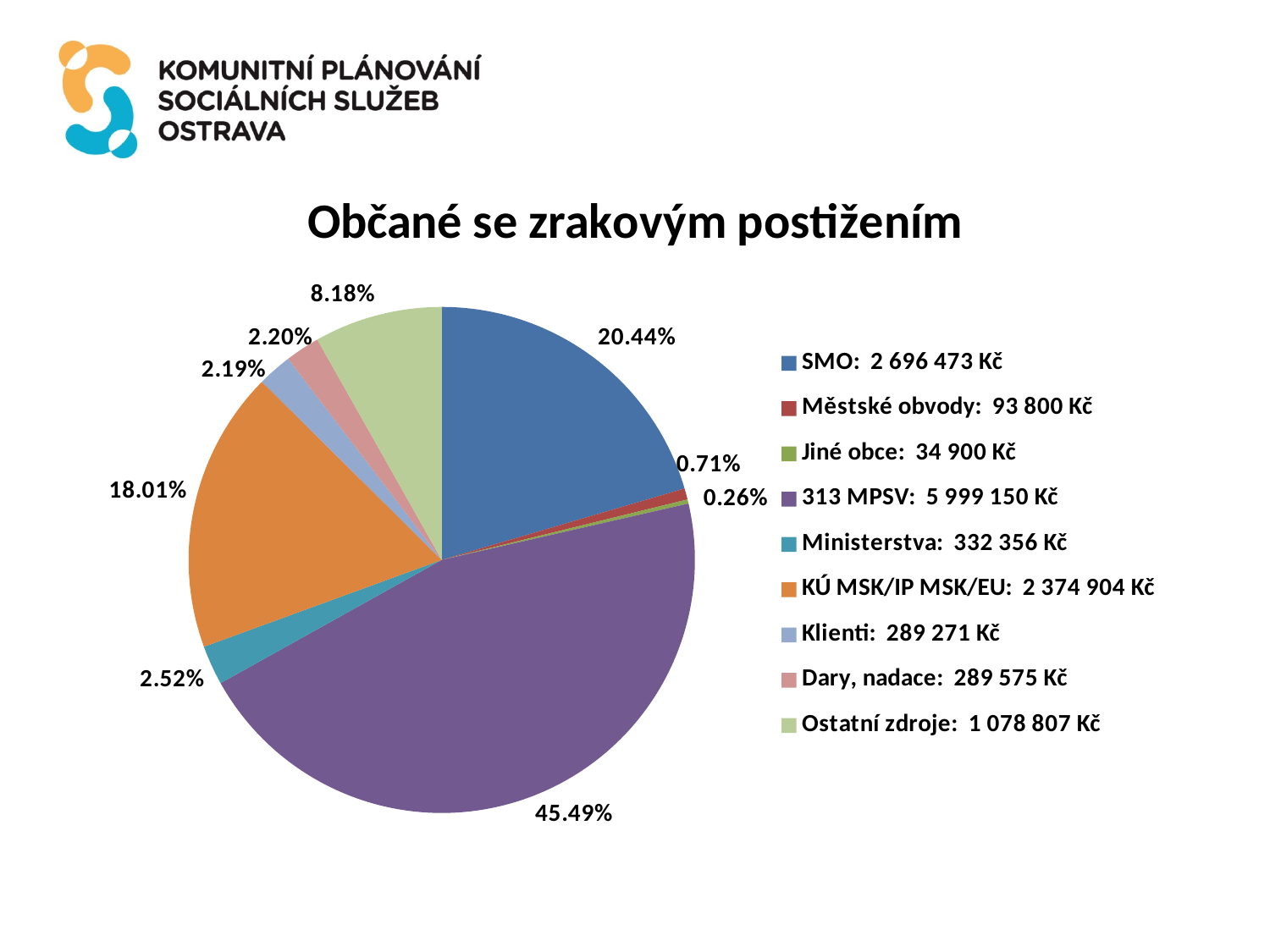
What kind of chart is shown on the slide? pie chart What share of the pie does 313 MPSV represent? 45.49% What amount is listed in the legend for Ministerstva? 332 356 Kč Which category has the smallest share of the pie? Jiné obce What share of the pie does Ostatní zdroje represent? 8.18% What share of the pie does KÚ MSK/IP MSK/EU represent? 18.01% What amount is listed in the legend for Dary, nadace? 289 575 Kč Which category has the largest share of the pie? 313 MPSV How many slices does the pie chart have? 9 Which is larger, the share for SMO or the share for KÚ MSK/IP MSK/EU? SMO What is the title of the chart? Občané se zrakovým postižením